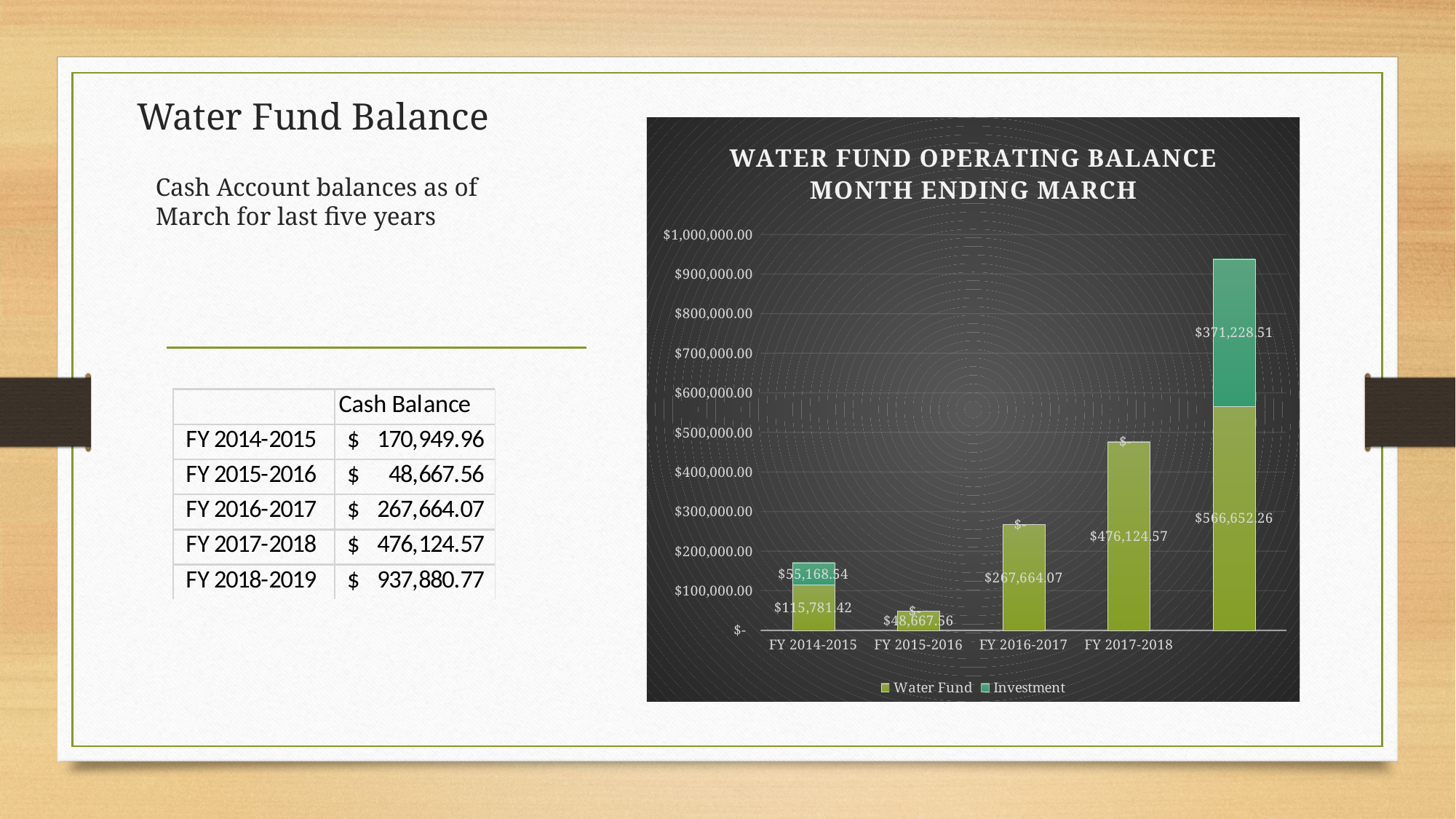
What is the Water Fund value for FY 2016-2017? $267,664.07 What is the total of the stacked bar for FY 2014-2015? $170,949.96 What is the Water Fund value for FY 2017-2018? $476,124.57 Which labeled fiscal year has the lowest Water Fund value? FY 2015-2016 What kind of chart is shown on the slide? Stacked bar chart How many series does the chart legend list? 2 What is the difference between the Water Fund values for FY 2017-2018 and FY 2016-2017? $208,460.50 What is the Water Fund value for FY 2014-2015? $115,781.42 What are the two series named in the chart legend? Water Fund and Investment Is the total bar height for FY 2017-2018 greater or less than $400,000.00? greater Which has the larger Water Fund value, FY 2016-2017 or FY 2014-2015? FY 2016-2017 What is the Investment value for FY 2014-2015? $55,168.54